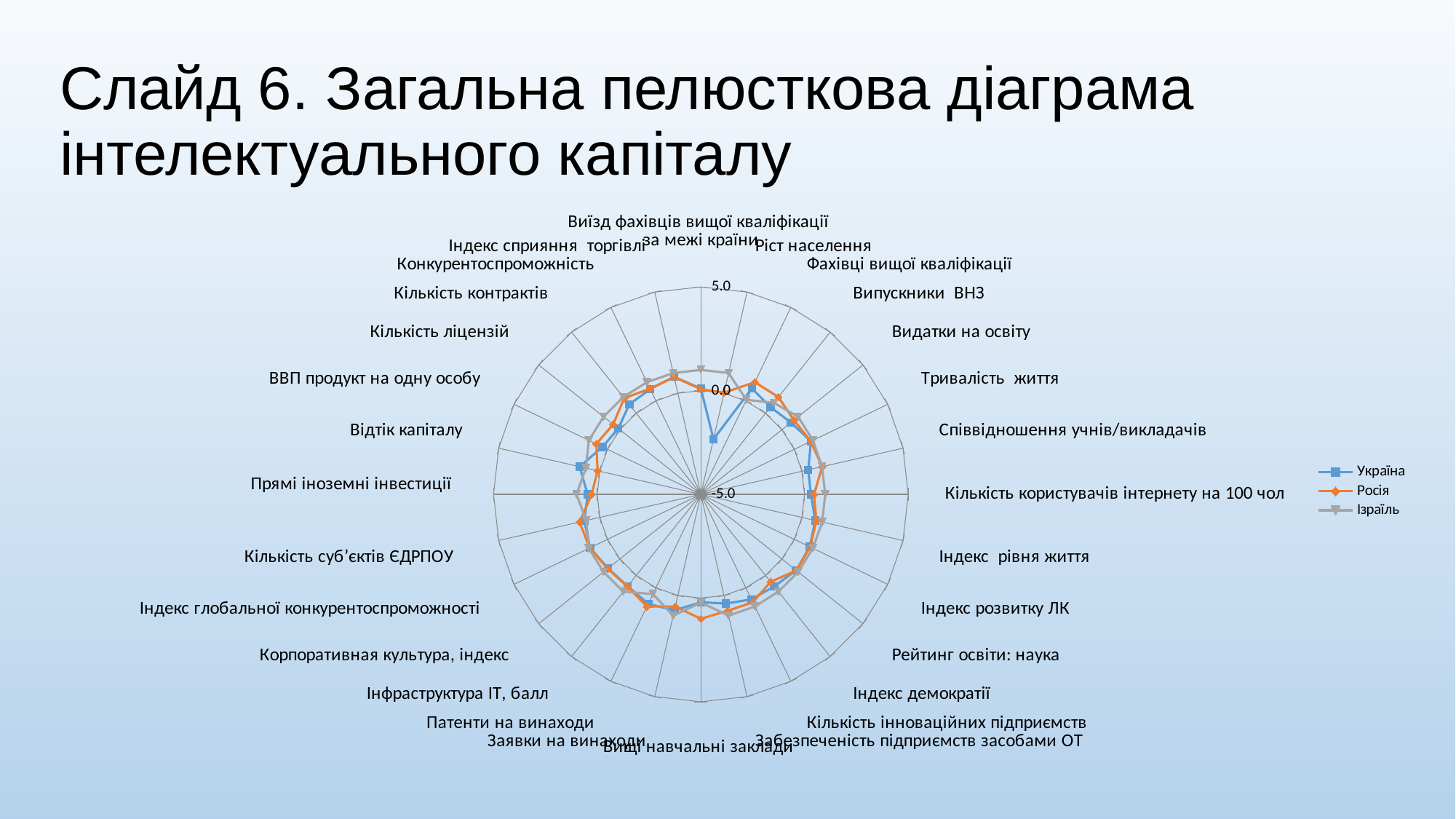
On the axis 'Виїзд фахівців вищої кваліфікації за межі країни', which series has the larger value, Україна or Ізраїль? Ізраїль How many series does the legend list? 3 Which series are listed in the chart legend? Україна, Росія, Ізраїль What is the highest value shown on the chart's radial axis? 5.0 What kind of chart is shown on the slide? Radar chart How many category axes does the radar chart have? 28